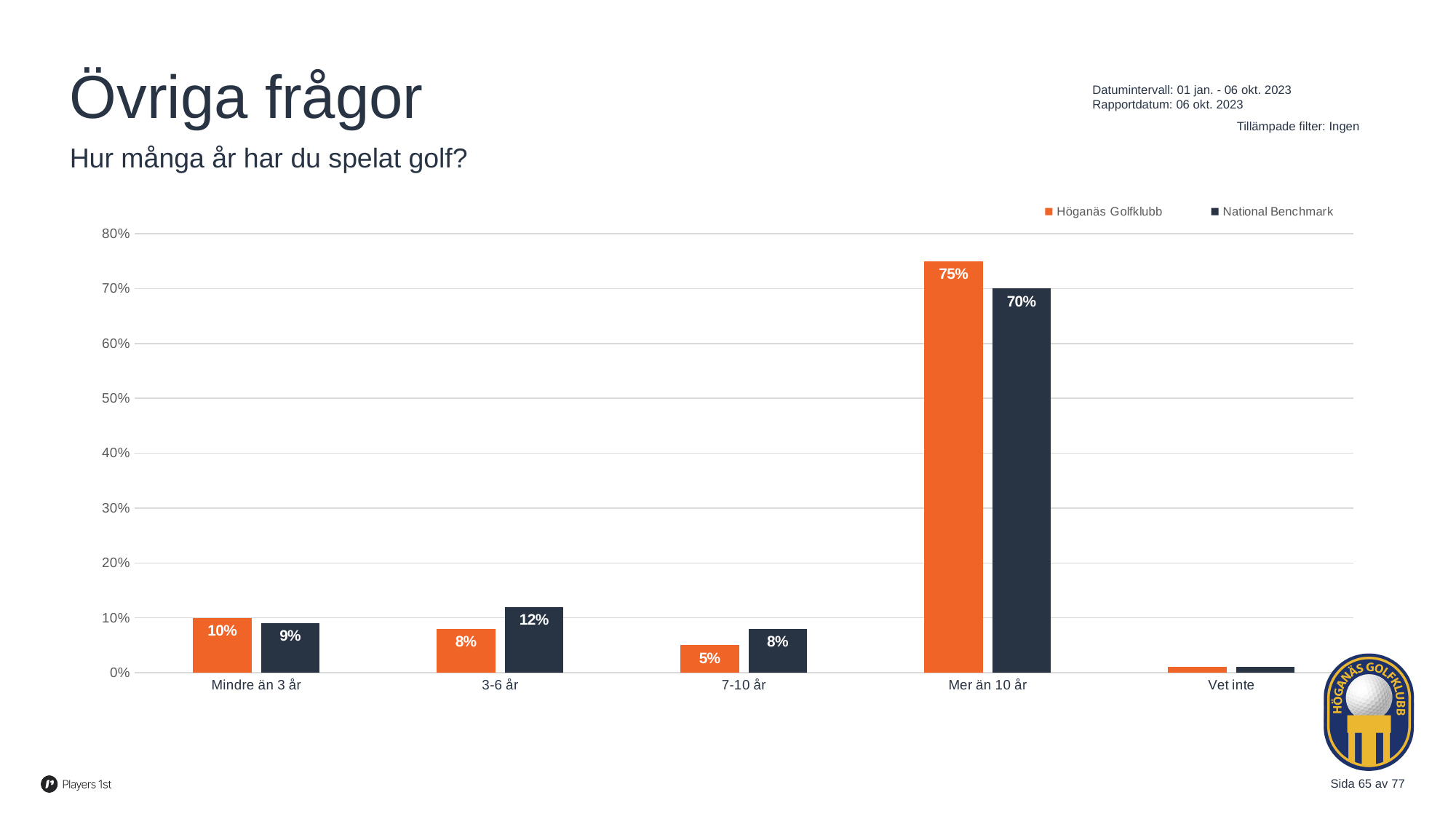
What is the National Benchmark value for the '3-6 år' category? 12% What is the difference between Höganäs Golfklubb and National Benchmark in the 'Mer än 10 år' category? 5% What is the Höganäs Golfklubb value for '7-10 år'? 5% What is the value for Höganäs Golfklubb in the 'Mer än 10 år' category? 75% In the '3-6 år' category, which is larger: Höganäs Golfklubb or National Benchmark? National Benchmark Which colour represents Höganäs Golfklubb in the chart? Orange What kind of chart is shown on the slide? Bar chart What is the difference between the Höganäs Golfklubb and National Benchmark values for 'Mindre än 3 år'? 1% Is the National Benchmark value for 'Mer än 10 år' greater or less than 60%? greater How many categories are shown on the x axis? 5 How many series does the legend list? 2 Which category has the highest value for Höganäs Golfklubb? Mer än 10 år